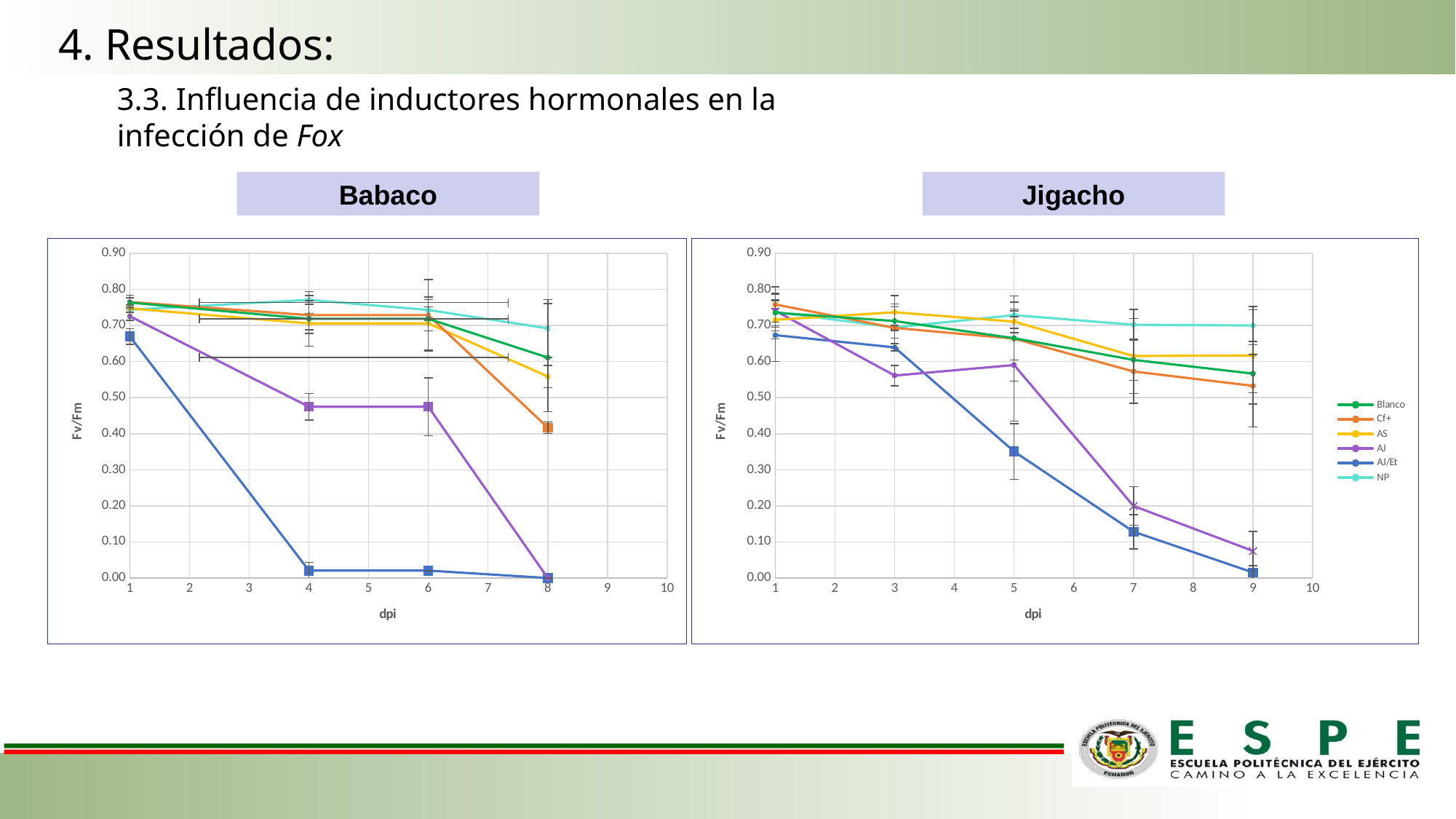
What is the y-axis label of the Jigacho chart? Fv/Fm In the Jigacho chart, is the value for AJ at 3 dpi greater or less than 0.60? less In the Babaco chart, is the value for NP at 4 dpi greater or less than 0.70? greater How many series does the legend list for the Jigacho chart? 6 What kind of chart is the Babaco chart? line chart In the Jigacho chart, is the value for AJ/Et at 5 dpi greater or less than 0.40? less In the Jigacho chart, which series has the lowest value at 9 dpi? AJ/Et In the Babaco chart, does the AJ/Et series rise or fall as dpi increases? fall In the Jigacho chart, which is larger at 5 dpi, AJ or AJ/Et? AJ In the Babaco chart, which is larger at 8 dpi, Blanco or Cf+? Blanco